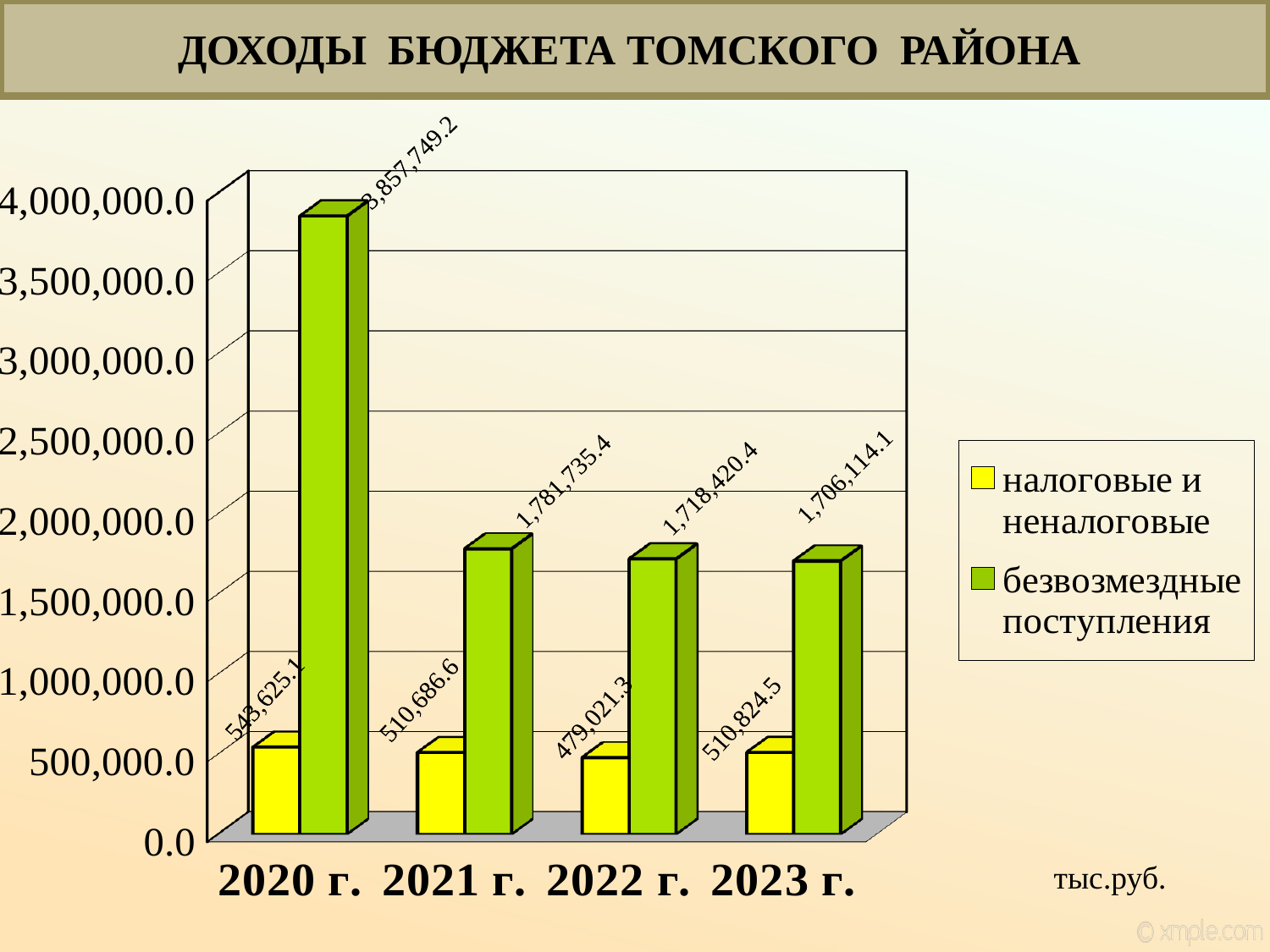
What is the value for безвозмездные поступления in 2020 г.? 3,857,749.2 Which is larger: безвозмездные поступления in 2021 г. or in 2022 г.? 2021 г. In which year is the value for налоговые и неналоговые the highest? 2020 г. What is the value for налоговые и неналоговые in 2022 г.? 479,021.3 What is the value for безвозмездные поступления in 2023 г.? 1,706,114.1 How many years are shown on the x axis? 4 How many series does the legend list? 2 What is the difference between безвозмездные поступления in 2020 г. and in 2021 г.? 2,076,013.8 In which year is the value for налоговые и неналоговые the lowest? 2022 г. What is the difference between налоговые и неналоговые in 2020 г. and in 2022 г.? 64,603.8 Is the value for безвозмездные поступления in 2022 г. greater or less than 2,000,000.0? less Do the values for безвозмездные поступления rise or fall from 2020 г. to 2023 г.? fall